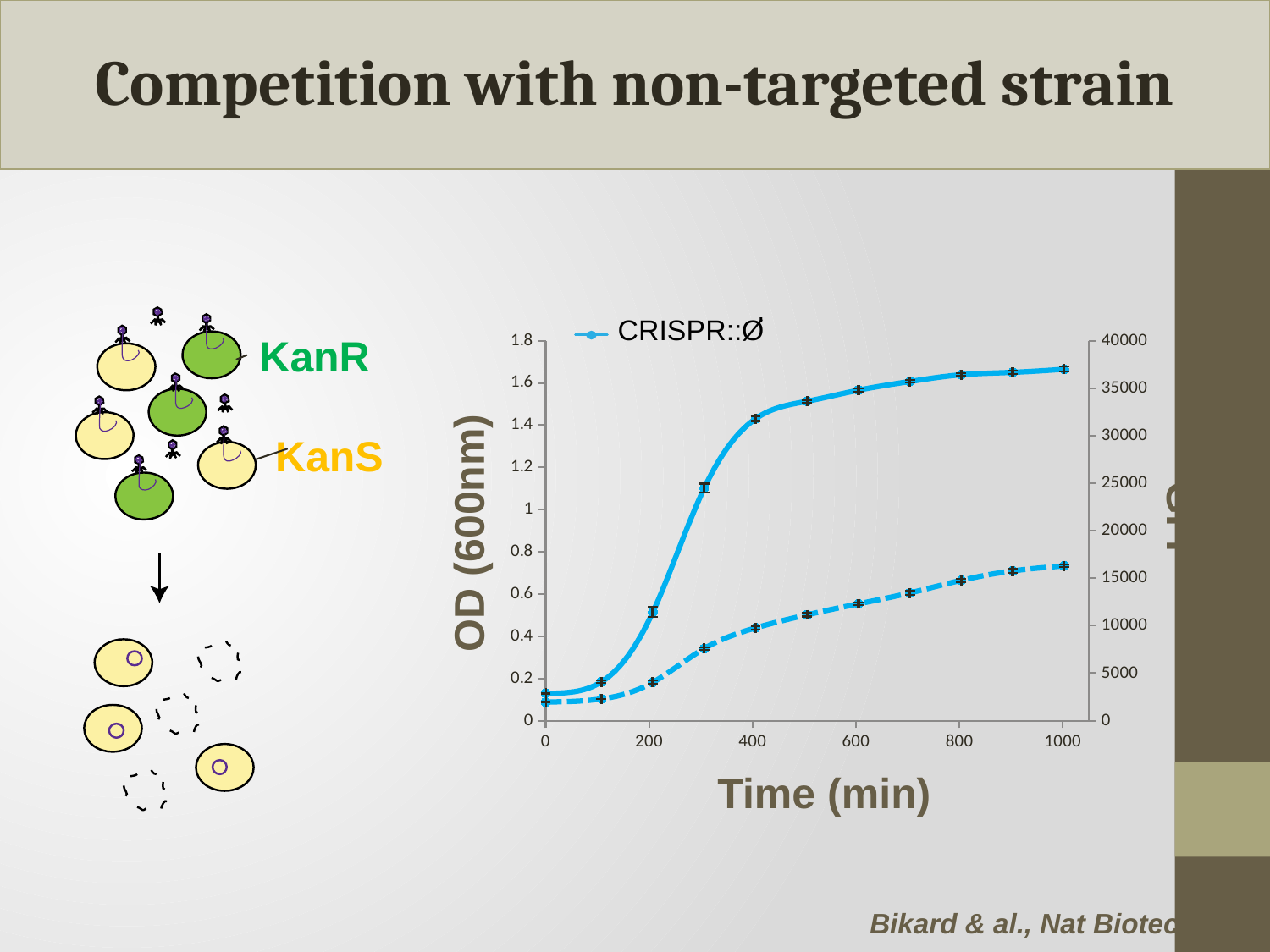
Does the dashed line rise or fall as time increases from 0 to 1000 min? rise Is the OD value of the solid CRISPR::Ø line at 400 min greater or less than 1.2? greater Is the OD value of the solid CRISPR::Ø line at 1000 min greater or less than 1.4? greater What is the title of the left y axis of the chart? OD (600nm) How many series does the chart's legend list? 1 What kind of chart is shown on the slide? line chart How many data points are plotted on the solid CRISPR::Ø line? 11 Does the solid CRISPR::Ø line rise or fall as time increases? rise What is the title of the x axis of the chart? Time (min)